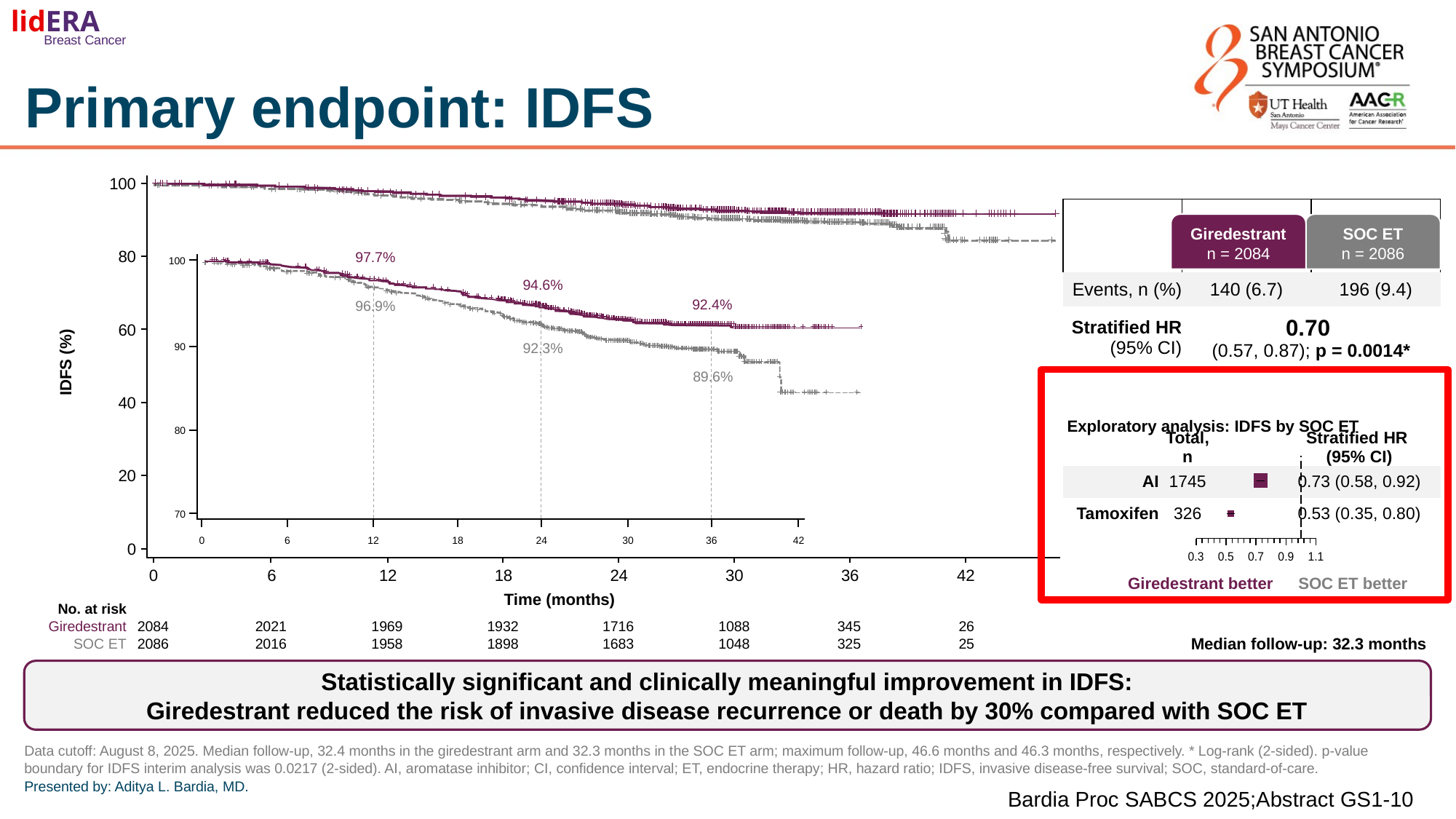
In the Kaplan-Meier chart, what is the difference between the giredestrant and SOC ET IDFS rates at 36 months? 2.8% How many treatment arms are plotted in the Kaplan-Meier chart? 2 What kind of chart is the main IDFS plot on the left of the slide? Line chart (Kaplan-Meier survival curve) What is the x-axis label of the Kaplan-Meier chart? Time (months) In the number-at-risk table below the Kaplan-Meier chart, how many giredestrant patients were at risk at 18 months? 1932 In the number-at-risk table below the Kaplan-Meier chart, how many SOC ET patients were at risk at 30 months? 1048 In the forest plot of the exploratory analysis, what is the total n for the AI subgroup? 1745 In the Kaplan-Meier chart, do the IDFS curves rise or fall as time in months increases? Fall In the Kaplan-Meier chart, what is the IDFS rate for SOC ET at 24 months? 92.3% In the Kaplan-Meier chart, what is the IDFS rate for giredestrant at 12 months? 97.7% In the Kaplan-Meier chart, which arm has the higher IDFS rate at 24 months? Giredestrant In the forest plot of the exploratory analysis, what is the stratified HR (95% CI) for the tamoxifen subgroup? 0.53 (0.35, 0.80)